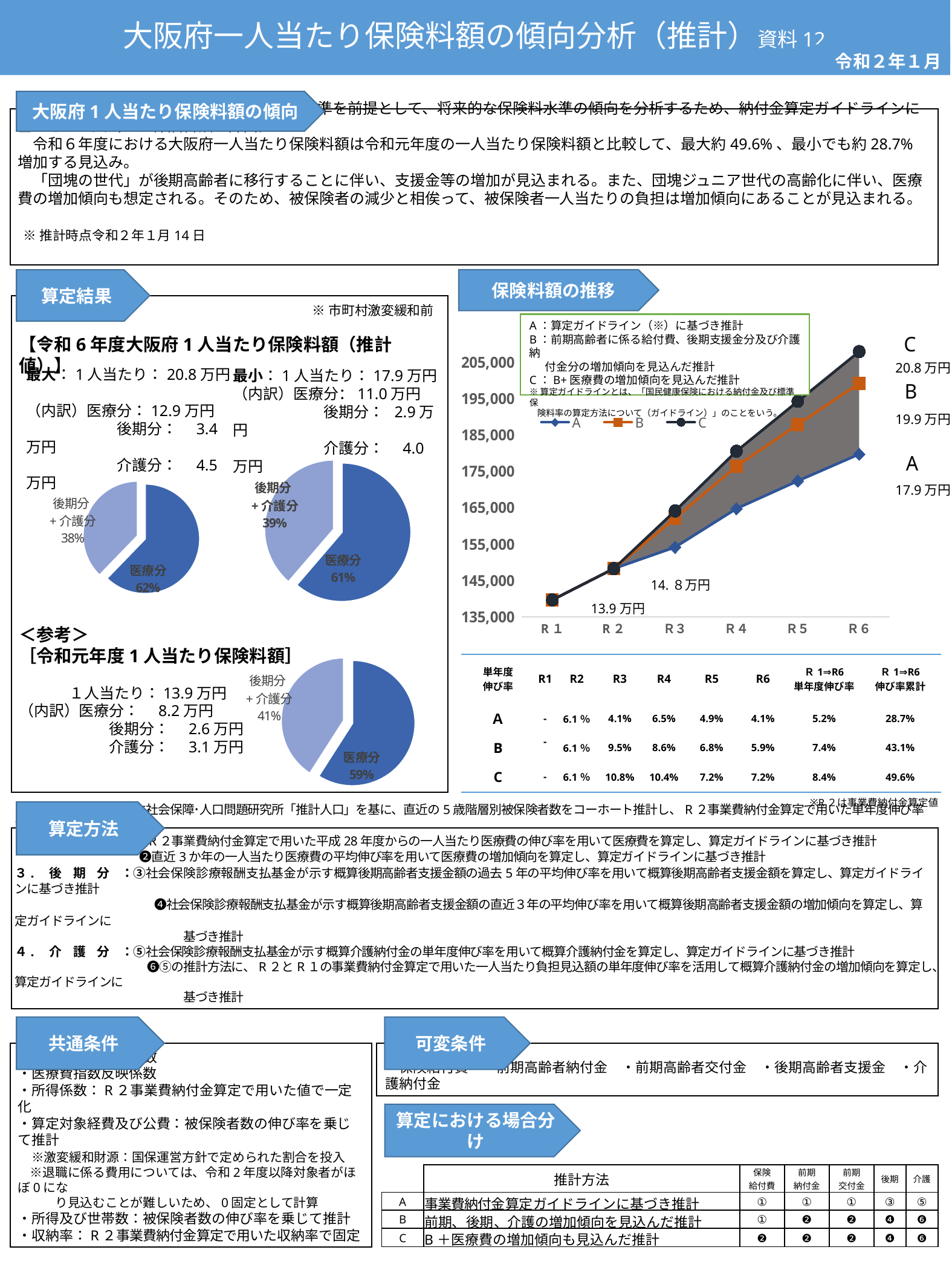
In the 令和元年度1人当たり保険料額 pie chart at the bottom left, what share does 後期分+介護分 have? 41% In the 保険料額の推移 line chart, what is the labelled value at R1? 13.9万円 In the 保険料額の推移 line chart, which series has the highest value at R6? C In the 保険料額の推移 line chart, is the value of series B at R5 greater or less than 185,000? greater How many points along the x axis (R1 to R6) does the 保険料額の推移 line chart show? 6 In the 保険料額の推移 line chart, do the values rise or fall from R1 to R6? rise How many series does the legend of the 保険料額の推移 line chart list? 3 In the 保険料額の推移 line chart, what is the labelled value of series A at R6? 17.9万円 In the 保険料額の推移 line chart, what is the labelled value of series C at R6? 20.8万円 In the 保険料額の推移 line chart, what is the difference between series C and series A at R6? 2.9万円 What kind of chart is the 保険料額の推移 chart on the right side of the slide? line chart In the 保険料額の推移 line chart, which is larger at R6: series B or series A? B